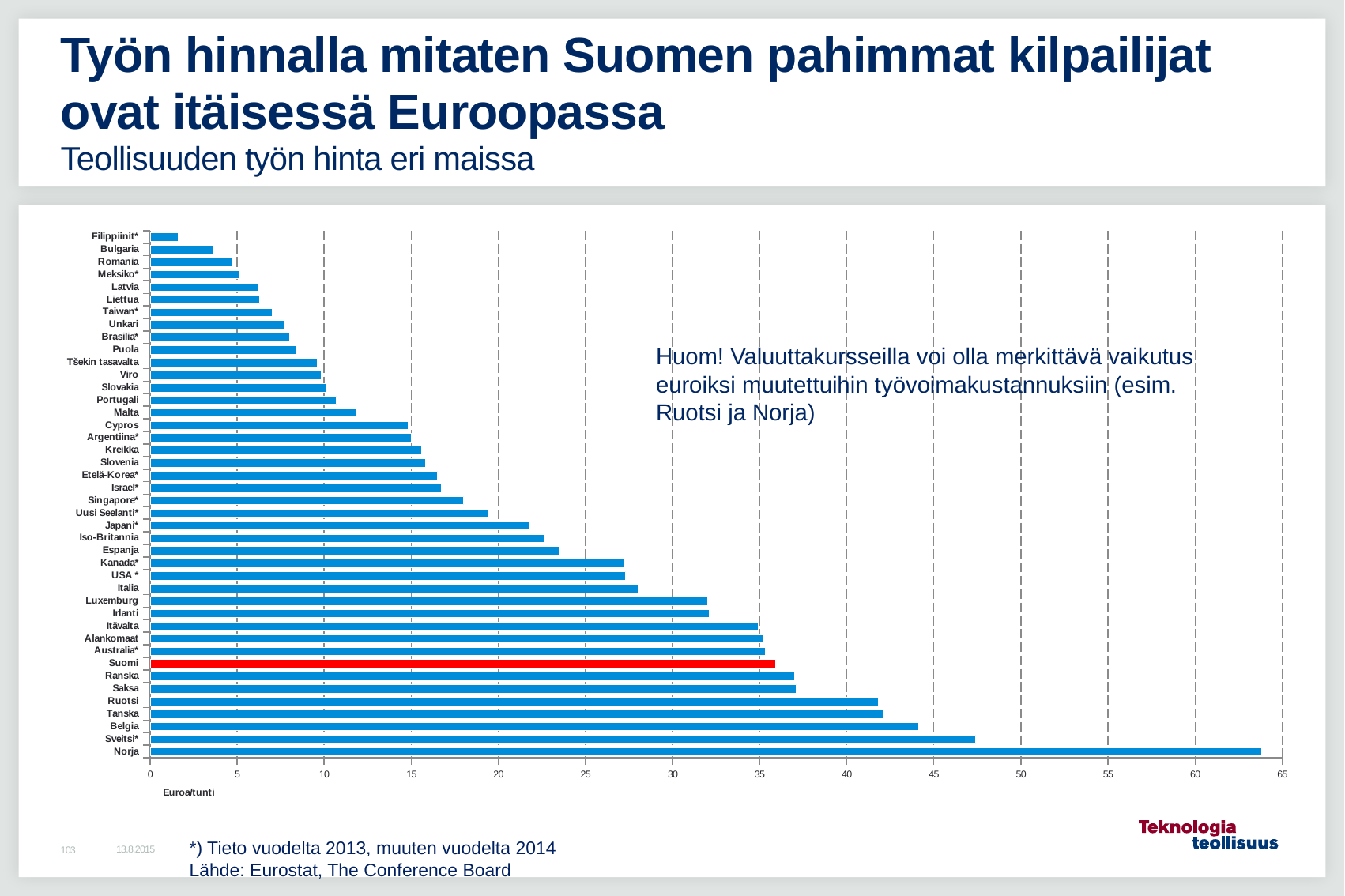
Is the value for Norja greater or less than 60? greater Which country has the highest value in the chart? Norja Is the value for Filippiinit* greater or less than 5? less How many countries are listed in the chart? 42 Is the value for Sveitsi* greater or less than 45? greater Which has the larger value, Norja or Sveitsi*? Norja What unit is shown on the x axis of the chart? Euroa/tunti Which bar is highlighted in red in the chart? Suomi Which country has the lowest value in the chart? Filippiinit* What kind of chart is shown on the slide? bar chart